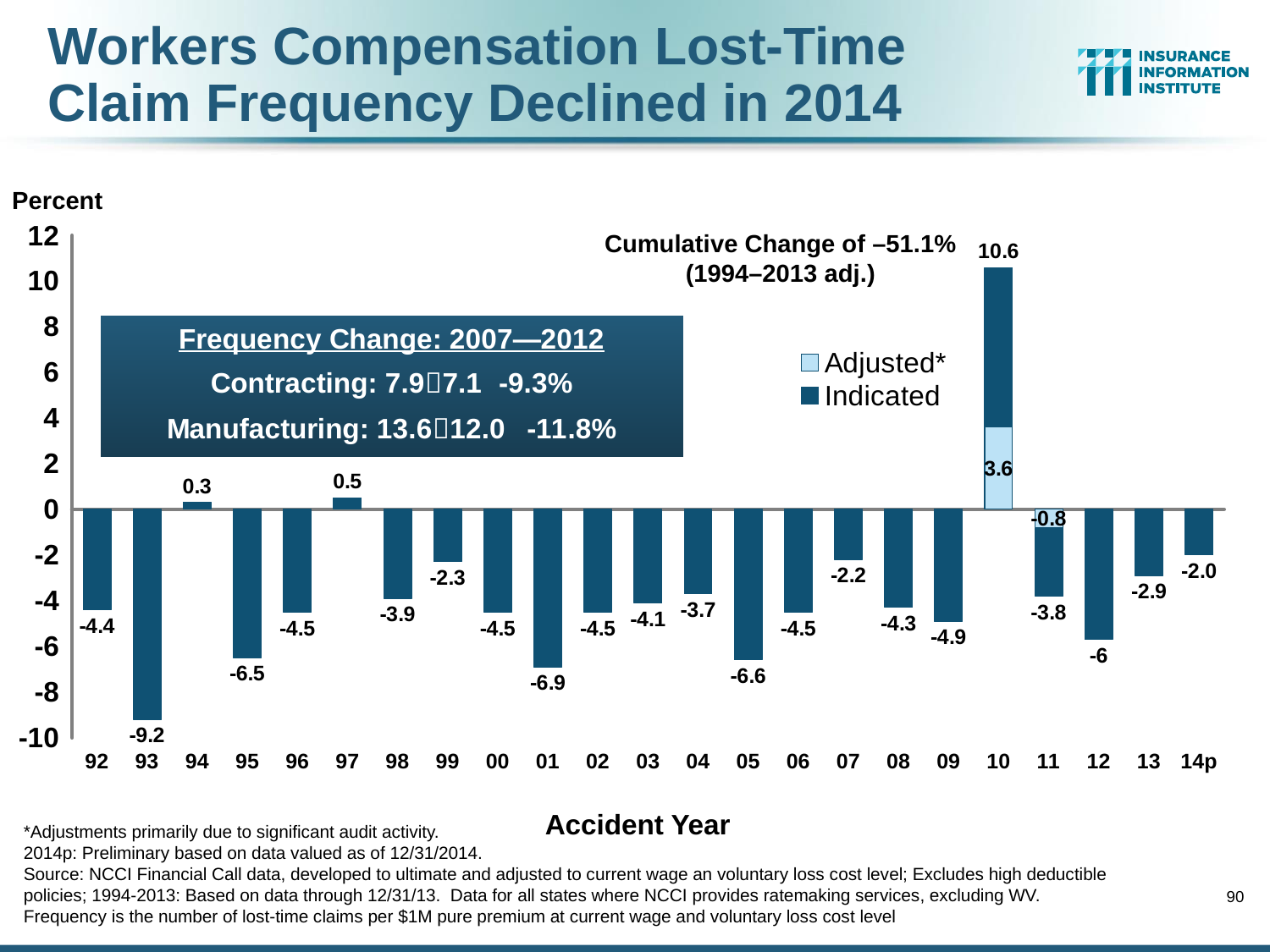
What is the Indicated value for accident year 10? 10.6 What is the Adjusted value for accident year 10? 3.6 How many series does the legend list? 2 Which accident year has the highest value? 10 How many accident years are shown on the x axis? 23 What is the value for accident year 14p? -2.0 What is the value for accident year 93? -9.2 What is the difference between the values for accident years 12 and 13? 3.1 What cumulative change is noted on the chart for 1994–2013 (adj.)? –51.1% What kind of chart is shown on the slide? Bar chart Which accident year has a larger value, 01 or 05? 05 Which accident year has the lowest value? 93